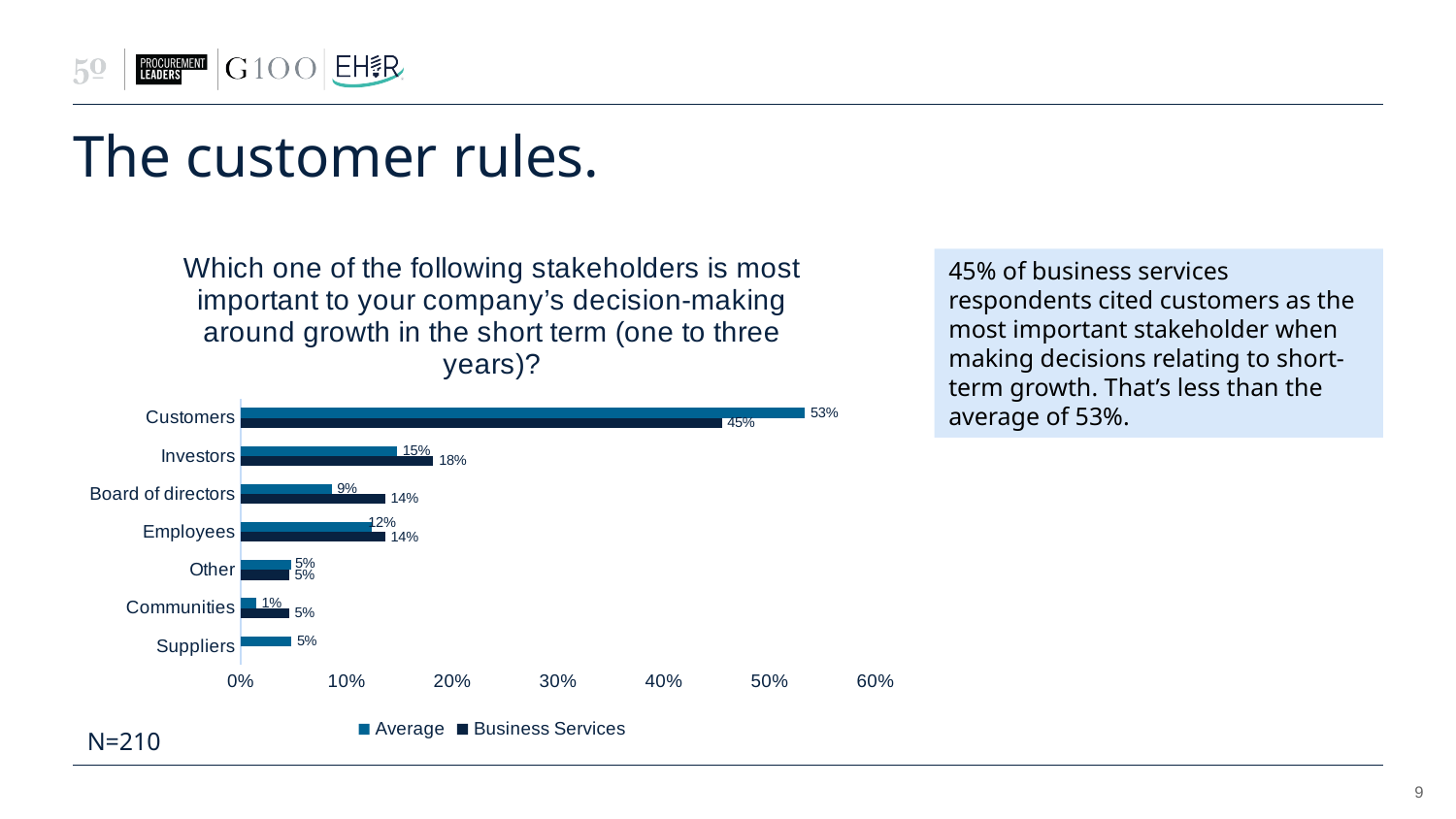
What is the difference between the Average and Business Services values for Customers? 8% Which stakeholder has the lowest Average value? Communities What is the Average value for Communities? 1% How many series does the legend list? 2 What is the Average value for Customers? 53% Which stakeholder has the highest Average value? Customers How many stakeholder categories are shown on the chart? 7 What is the sample size (N) stated on the slide? N=210 What is the Business Services value for Investors? 18% For Board of directors, which is larger: the Average value or the Business Services value? Business Services What is the Business Services value for Customers? 45% What kind of chart is shown on the slide? Bar chart